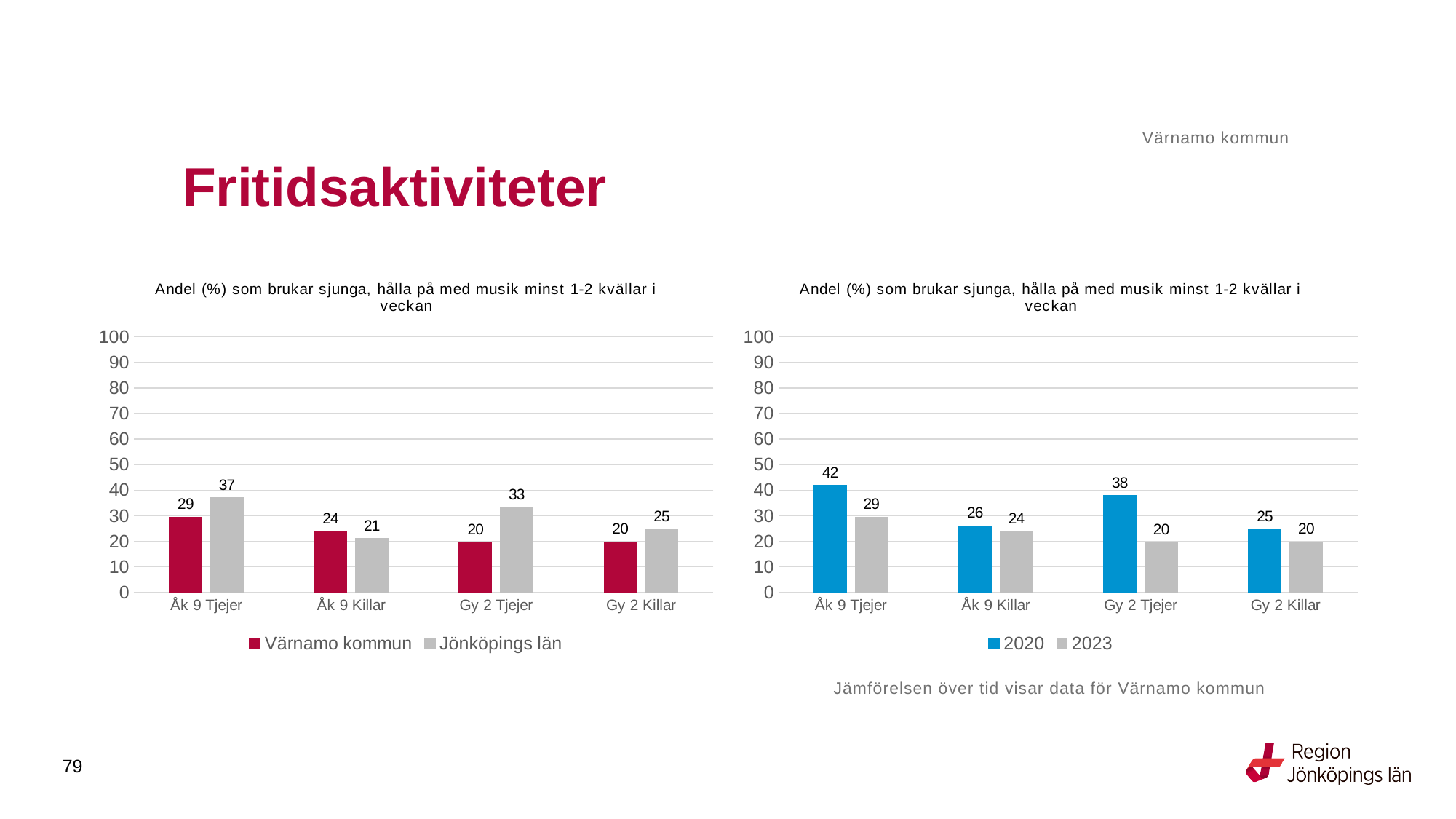
In the right chart, which category has the lowest value for 2020? Gy 2 Killar In the left chart, which category has the highest value for Jönköpings län? Åk 9 Tjejer In the left chart, what is the difference between Jönköpings län and Värnamo kommun for Gy 2 Tjejer? 13 How many series does the legend of the right chart list? 2 How many categories are shown on the x axis of the left chart? 4 In the left chart, which is larger for Åk 9 Killar: Värnamo kommun or Jönköpings län? Värnamo kommun What kind of chart is the right chart? Bar chart In the right chart, what is the value for 2023 for Gy 2 Killar? 20 In the right chart, what is the difference between 2020 and 2023 for Gy 2 Tjejer? 18 In the left chart, what is the value for Jönköpings län for Gy 2 Tjejer? 33 In the left chart, what is the value for Värnamo kommun for Åk 9 Tjejer? 29 In the right chart, what is the value for 2020 for Åk 9 Tjejer? 42